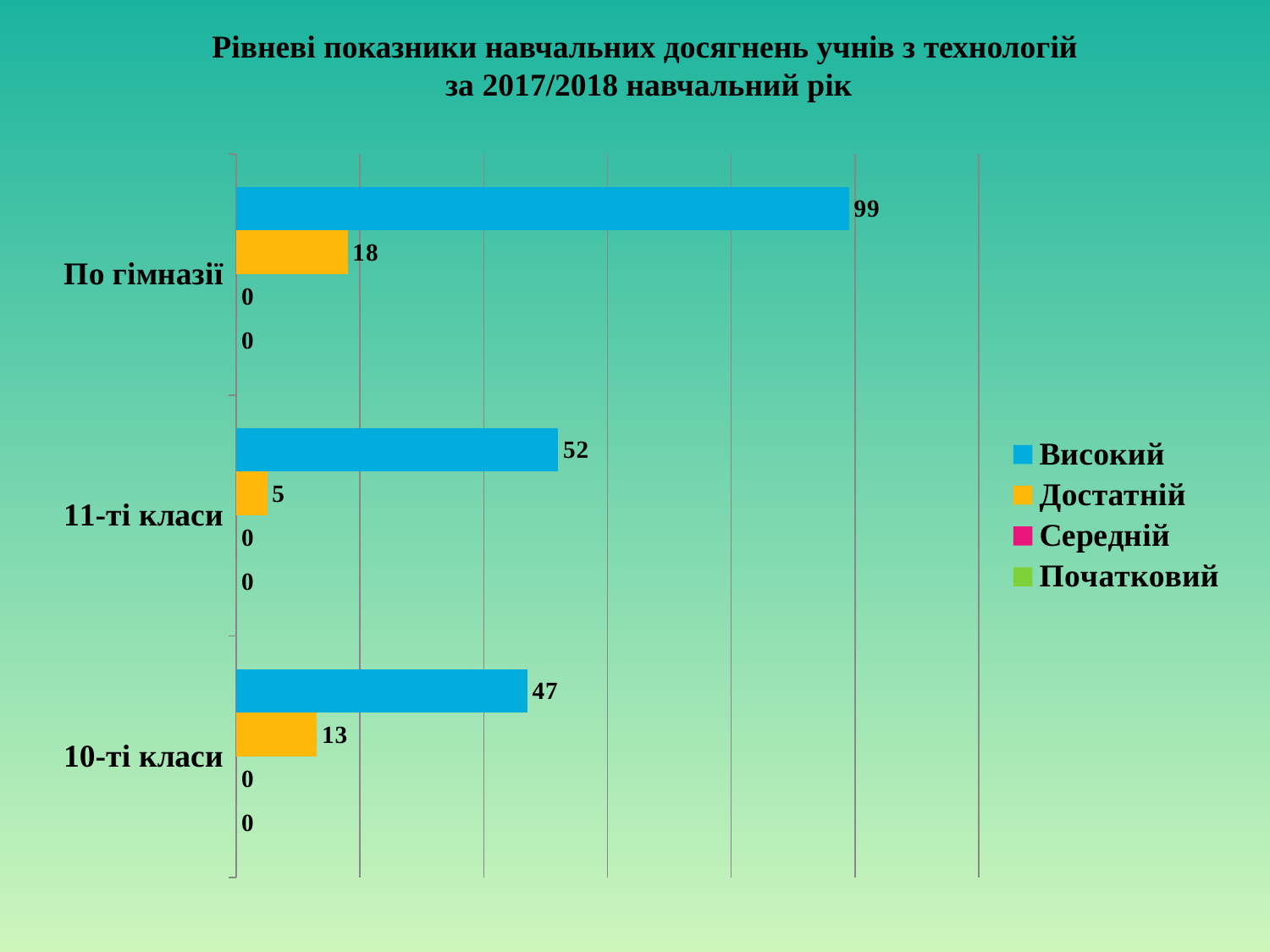
How many series does the legend list? 4 What is the value for Високий for По гімназії? 99 Which is larger: the Достатній value for По гімназії or for 10-ті класи? По гімназії Which category has the lowest value for Достатній? 11-ті класи What is the difference between the Високий values for 11-ті класи and 10-ті класи? 5 What kind of chart is shown on the slide? Bar chart Which category has the highest value for Високий? По гімназії How many categories are shown on the chart? 3 What is the value for Середній for 11-ті класи? 0 What is the value for Високий for 10-ті класи? 47 What is the value for Достатній for 10-ті класи? 13 What is the value for Достатній for 11-ті класи? 5